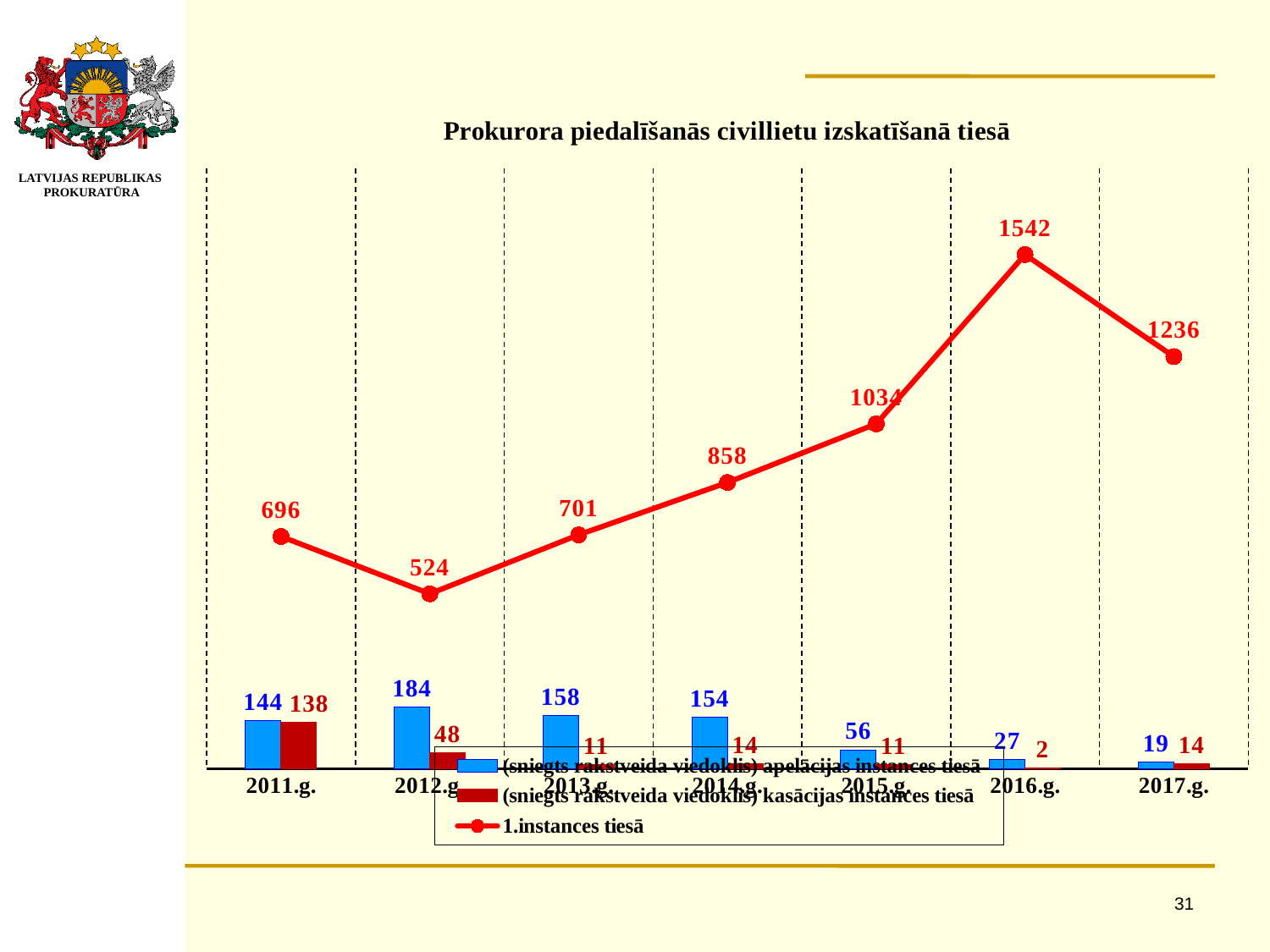
How many years are shown on the x axis? 7 What is the value of the 1.instances tiesā line for 2016.g.? 1542 What is the title of the chart? Prokurora piedalīšanās civillietu izskatīšanā tiesā Does the 1.instances tiesā line rise or fall from 2012.g. to 2016.g.? rise Which is larger for 2014.g.: the apelācijas instances tiesā bar or the kasācijas instances tiesā bar? apelācijas instances tiesā In which year does the 1.instances tiesā line reach its highest value? 2016.g. What is the value of the blue apelācijas instances tiesā bar for 2012.g.? 184 What kind of chart is this? Combined bar and line chart In which year is the 1.instances tiesā line at its lowest value? 2012.g. What is the difference between the 1.instances tiesā values for 2016.g. and 2017.g.? 306 How many series does the legend list? 3 What is the value of the red kasācijas instances tiesā bar for 2011.g.? 138